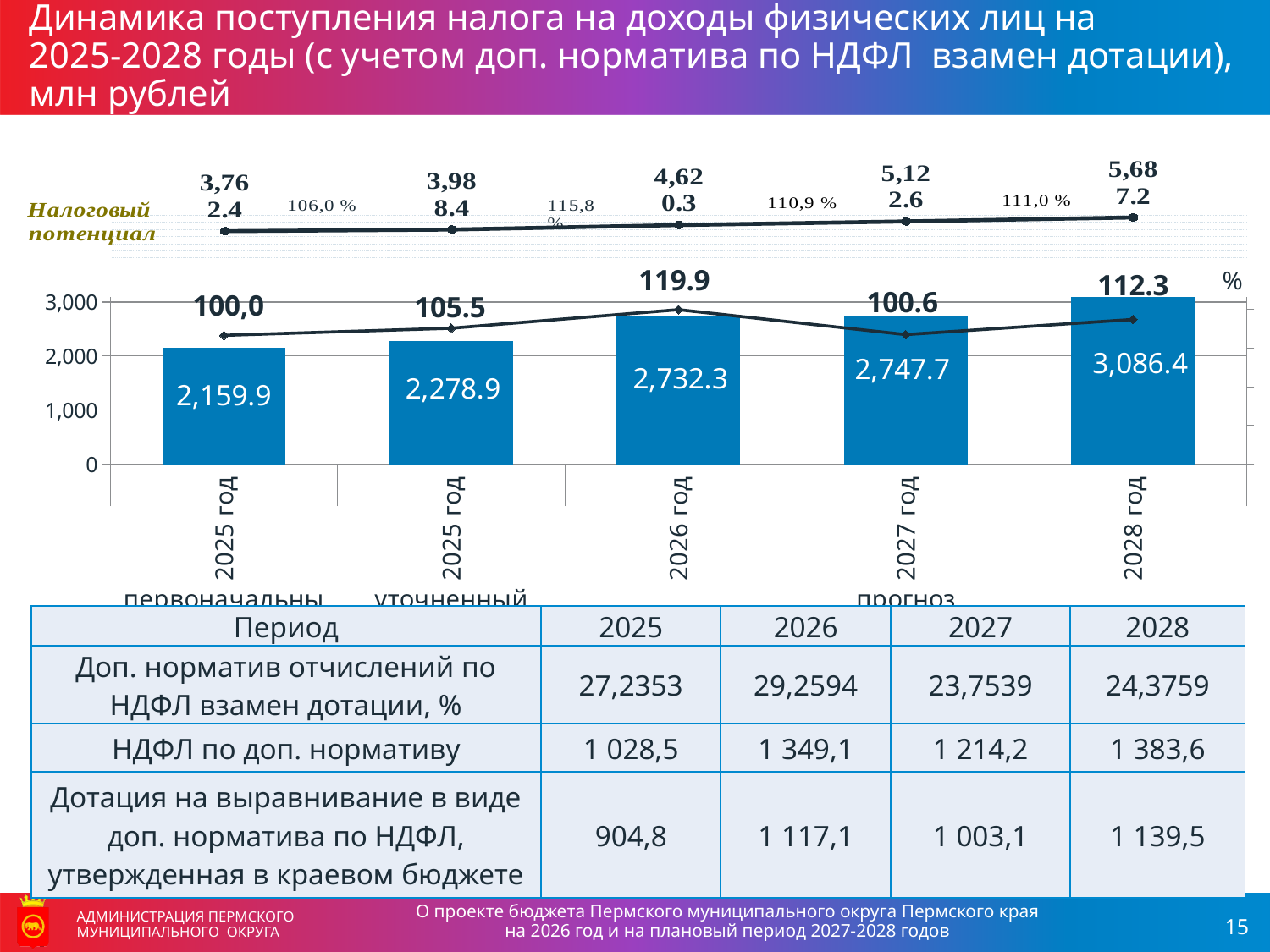
Which is larger, the bar for 2026 год or the bar for 2027 год? 2027 год What is the difference between the bar values for 2028 год and 2027 год? 338.7 Which year has the highest bar value? 2028 год What is the value of the bar for 2025 год (уточненный)? 2,278.9 What is the value of the bar for 2026 год? 2,732.3 What is the value of the bar for 2028 год? 3,086.4 What type of chart is used to show the НДФЛ values? bar chart How many bars are plotted in the chart? 5 Which bar has the lowest value? 2025 год (первоначальный) Do the bar values rise or fall from 2025 год (первоначальный) to 2028 год? rise What percentage label is shown on the line above the bar for 2026 год? 119.9 What is the value of the first bar, 2025 год (первоначальный)? 2,159.9